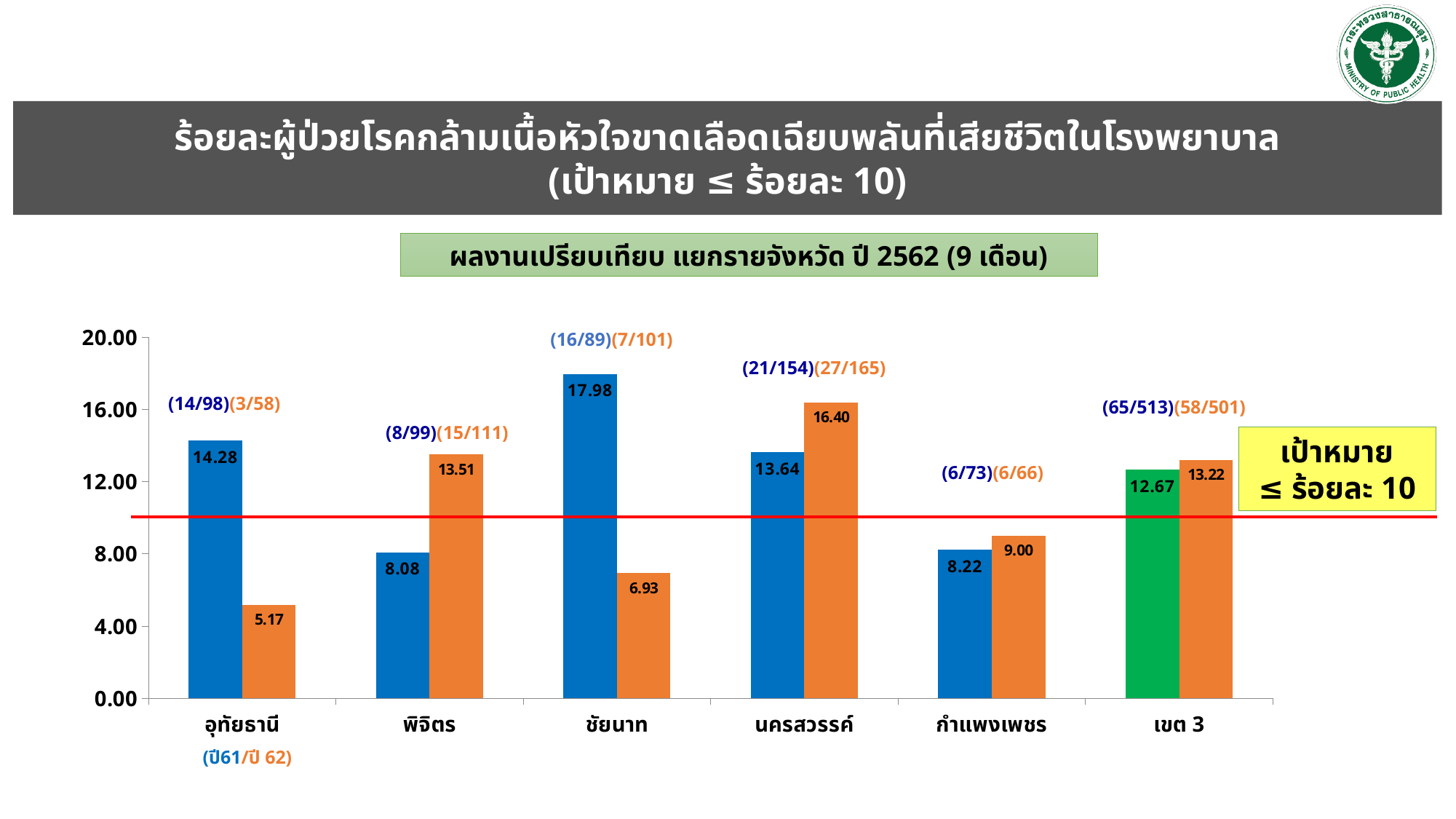
What kind of chart is shown on the slide? bar chart What is the difference between the ปี61 and ปี 62 values for นครสวรรค์? 2.76 Which category has the lowest ปี 62 value? อุทัยธานี What is the ปี 62 value for เขต 3? 13.22 How many categories are shown on the x axis? 6 Which province has the highest ปี61 value? ชัยนาท Is the ปี 62 value for กำแพงเพชร greater or less than 12.00? less How many data series are plotted for each category? 2 What target value does the red horizontal line on the chart represent? ร้อยละ 10 What is the ปี61 value for ชัยนาท? 17.98 What is the ปี 62 value for พิจิตร? 13.51 For อุทัยธานี, which is larger: the ปี61 value or the ปี 62 value? ปี61